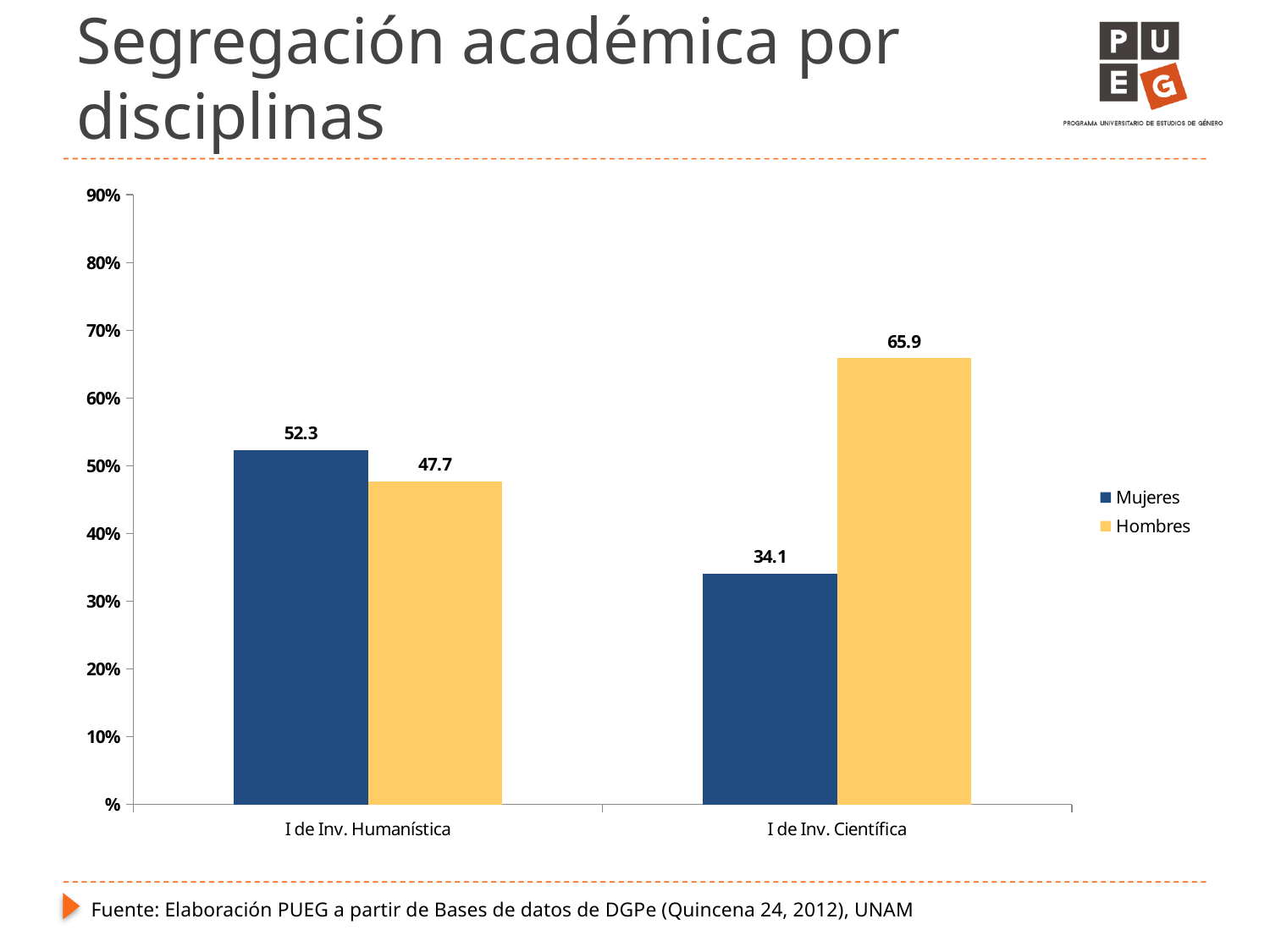
How many categories are shown on the x axis? 2 How many series does the legend list? 2 Which category has the highest value for Hombres? I de Inv. Científica Which category has the lowest value for Mujeres? I de Inv. Científica What kind of chart is shown on the slide? Bar chart What is the value for Hombres in I de Inv. Científica? 65.9 What is the value for Mujeres in I de Inv. Científica? 34.1 What is the value for Mujeres in I de Inv. Humanística? 52.3 What is the difference between Hombres and Mujeres in I de Inv. Científica? 31.8 Which is larger in I de Inv. Humanística, Mujeres or Hombres? Mujeres Is the value for Hombres in I de Inv. Científica greater or less than 60%? greater What is the value for Hombres in I de Inv. Humanística? 47.7